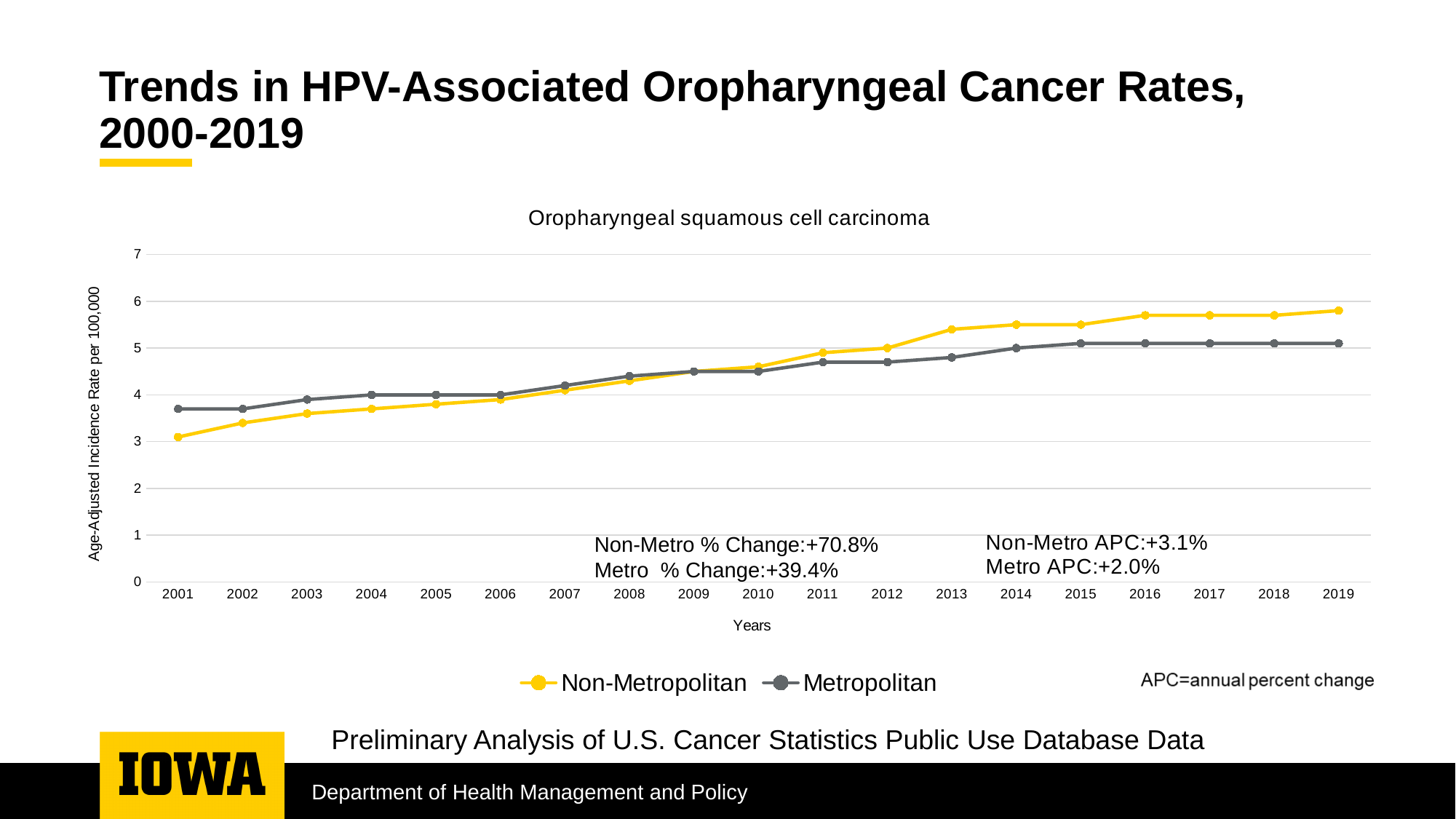
In which year is the Non-Metropolitan rate lowest? 2001 Is the Non-Metropolitan value for 2019 greater or less than 5? greater In 2001, which series has the higher rate, Non-Metropolitan or Metropolitan? Metropolitan Is the Non-Metropolitan value for 2001 greater or less than 4? less Do the Non-Metropolitan values generally rise or fall from 2001 to 2019? rise In which year is the Non-Metropolitan rate highest? 2019 How many series does the legend list? 2 In 2019, which series has the higher rate, Non-Metropolitan or Metropolitan? Non-Metropolitan How many years are plotted along the x axis? 19 What is the title of the chart? Oropharyngeal squamous cell carcinoma What kind of chart is shown on the slide? line chart What Non-Metro % Change is annotated on the chart? +70.8%